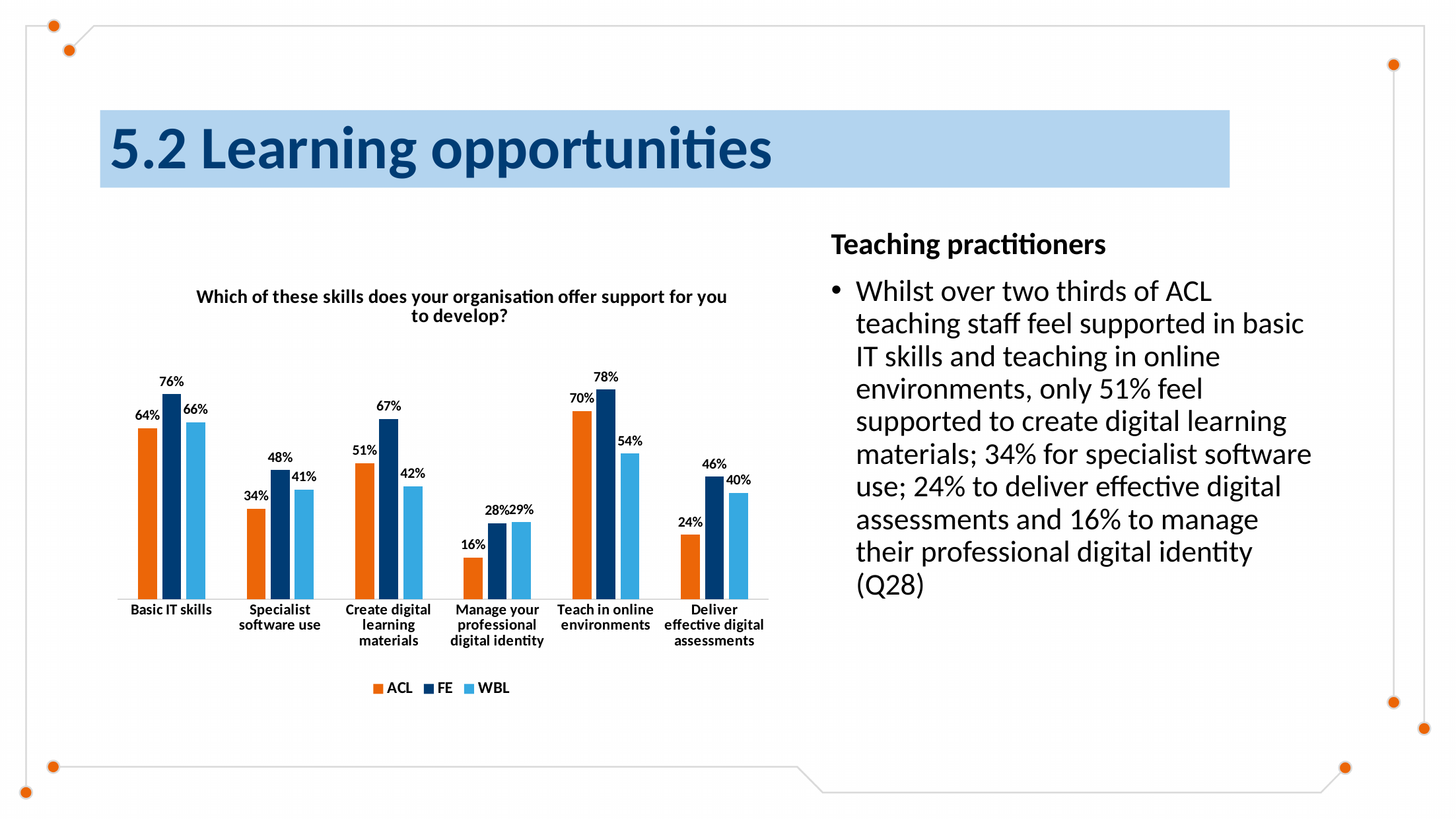
What is the FE value for Teach in online environments? 78% What kind of chart is shown on the slide? Bar chart What is the ACL value for Basic IT skills? 64% What is the difference between the FE and ACL values for Deliver effective digital assessments? 22% Which category has the lowest ACL value? Manage your professional digital identity Which series is shown in orange in the legend? ACL How many series does the legend list? 3 How many skill categories are shown on the x axis? 6 Which is larger for Specialist software use: the FE value or the WBL value? FE What is the WBL value for Create digital learning materials? 42% Which category has the highest FE value? Teach in online environments What is the ACL value for Manage your professional digital identity? 16%